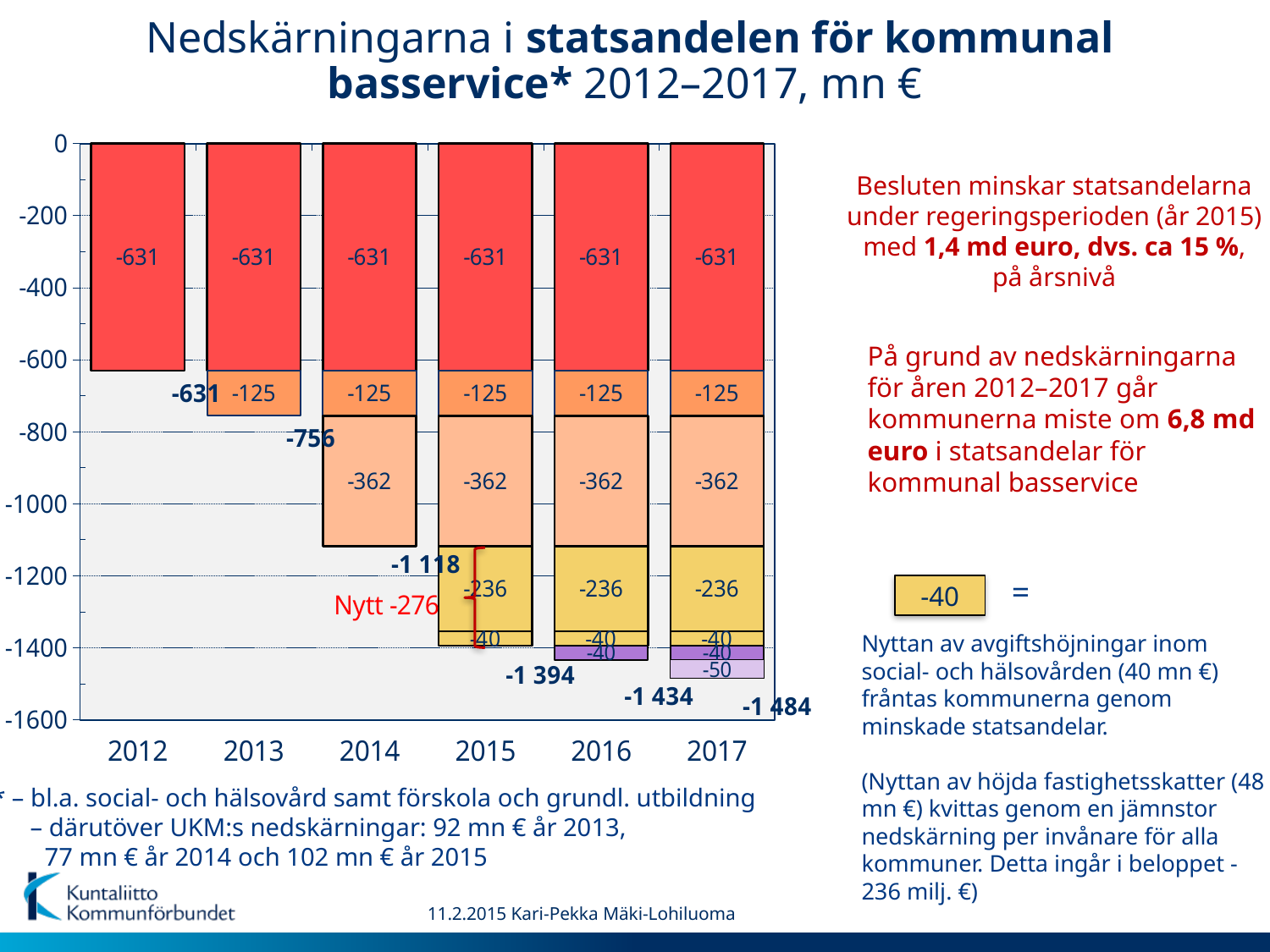
By how much does the labelled total for 2017 (-1 484) differ from the total for 2016 (-1 434)? 50 How many segments make up the 2017 bar? 7 How many years are shown on the x axis of the chart? 6 Do the labelled totals become more negative or less negative from 2012 to 2017? more negative Which year has the smallest total cut (the total closest to zero)? 2012 What kind of chart is shown on the slide? bar chart What is the value of the red segment in the 2012 bar? -631 What is the total value labelled for the 2017 bar? -1 484 What is the value of the light orange segment that first appears in the 2014 bar? -362 Which year has the largest total cut (the most negative total)? 2017 By how much does the labelled total for 2013 (-756) differ from the total for 2012 (-631)? 125 What is the total value labelled for the 2015 bar? -1 394